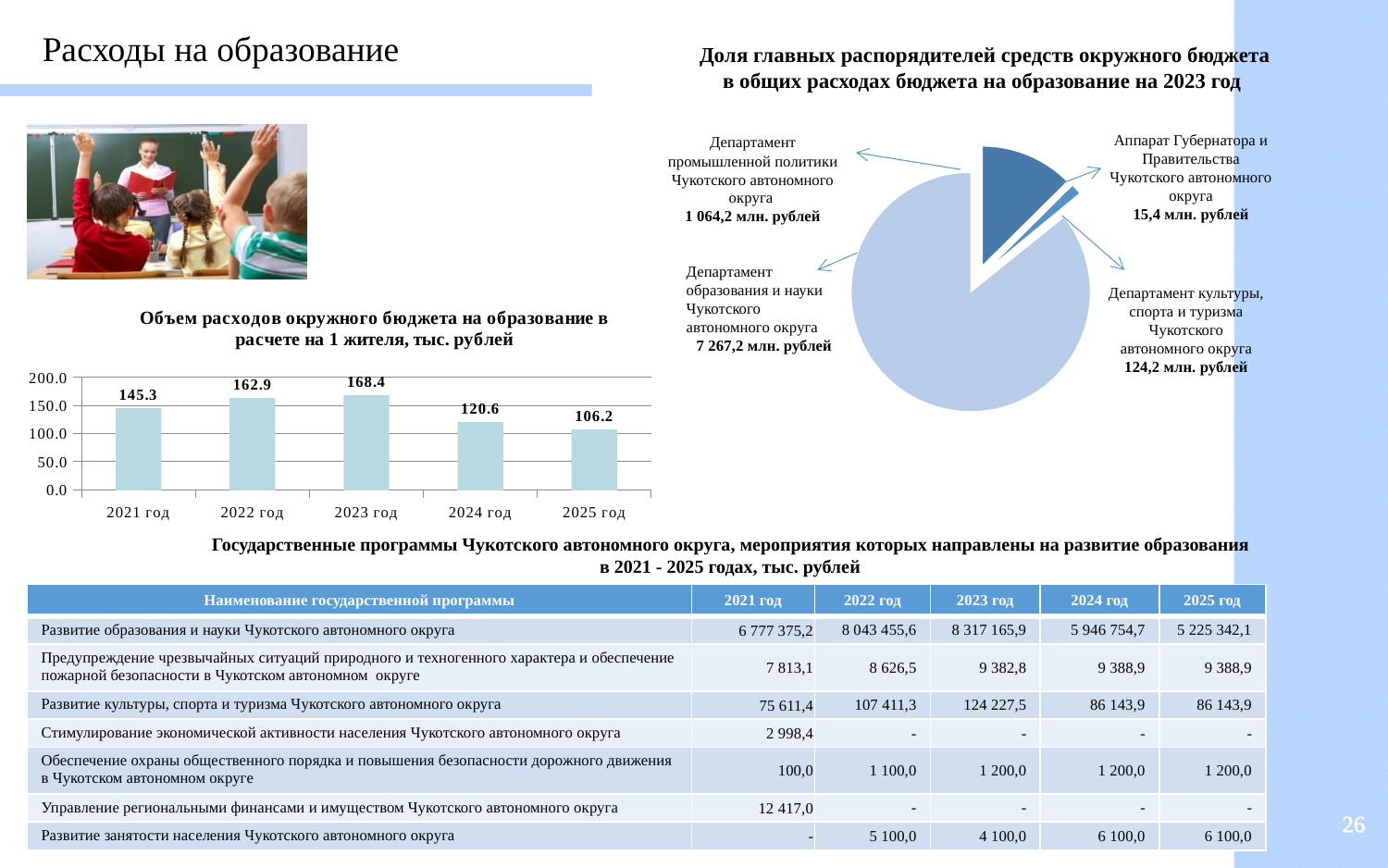
On the bar chart 'Объем расходов окружного бюджета на образование в расчете на 1 жителя', what is the difference between the values for 2022 год and 2021 год? 17.6 On the pie chart 'Доля главных распорядителей средств окружного бюджета в общих расходах бюджета на образование на 2023 год', how many slices are there? 4 On the bar chart 'Объем расходов окружного бюджета на образование в расчете на 1 жителя', which is larger: the value for 2021 год or the value for 2024 год? 2021 год On the pie chart 'Доля главных распорядителей средств окружного бюджета в общих расходах бюджета на образование на 2023 год', which slice is the smallest? Аппарат Губернатора и Правительства Чукотского автономного округа On the bar chart 'Объем расходов окружного бюджета на образование в расчете на 1 жителя', do the values rise or fall from 2023 год to 2025 год? fall On the bar chart 'Объем расходов окружного бюджета на образование в расчете на 1 жителя', how many years are shown? 5 On the bar chart 'Объем расходов окружного бюджета на образование в расчете на 1 жителя', which year has the lowest value? 2025 год On the bar chart 'Объем расходов окружного бюджета на образование в расчете на 1 жителя', what is the value for 2025 год? 106.2 On the bar chart 'Объем расходов окружного бюджета на образование в расчете на 1 жителя', which year has the highest value? 2023 год What kind of chart is the one titled 'Объем расходов окружного бюджета на образование в расчете на 1 жителя'? bar chart On the pie chart 'Доля главных распорядителей средств окружного бюджета в общих расходах бюджета на образование на 2023 год', what is the value for Департамент образования и науки Чукотского автономного округа? 7 267,2 млн. рублей On the bar chart 'Объем расходов окружного бюджета на образование в расчете на 1 жителя', what is the value for 2023 год? 168.4